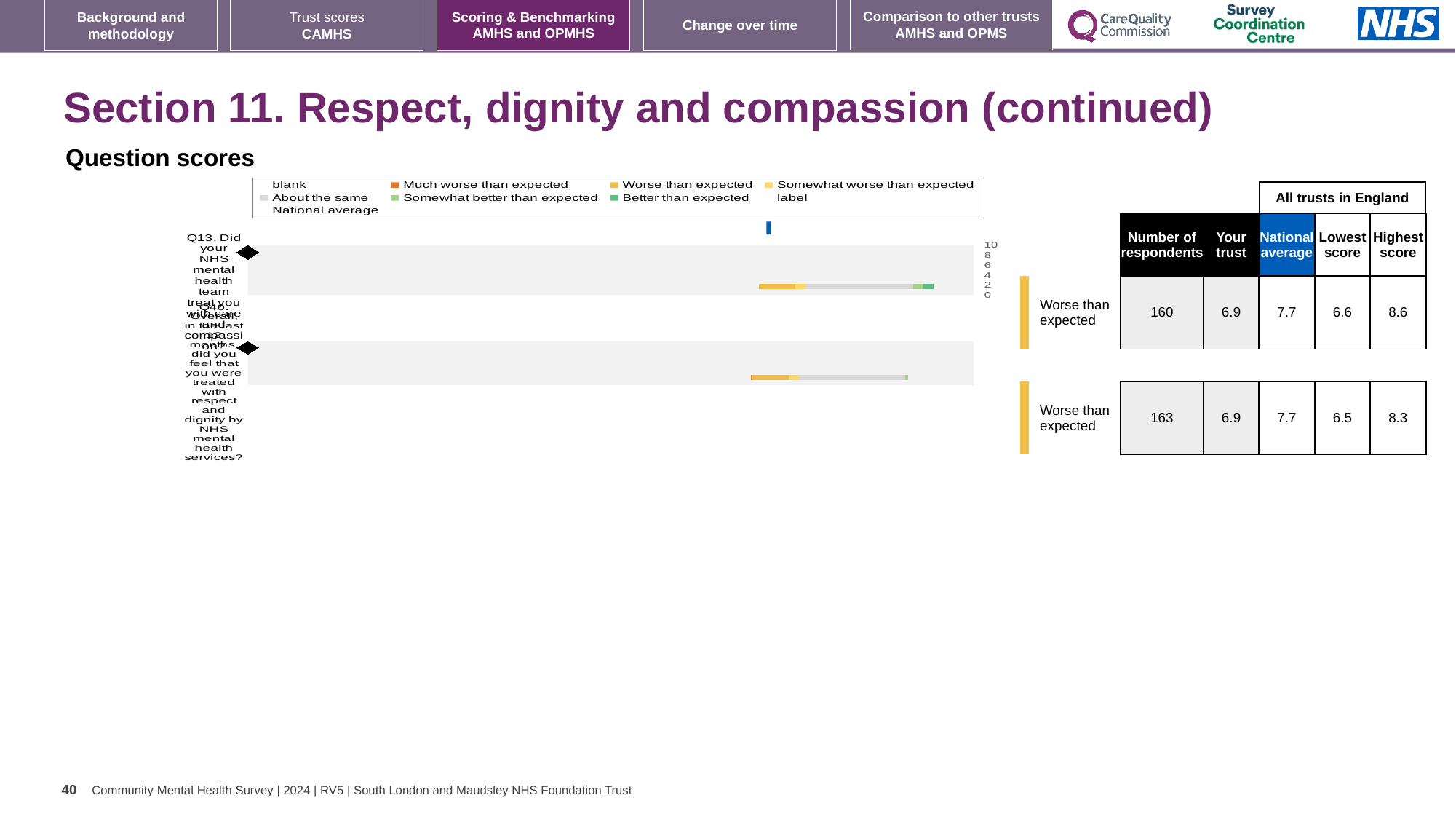
In the table, what is the difference between the Highest score and the Lowest score in the top row (8.6 and 6.6)? 2.0 How many questions (categories) are plotted in the chart? 2 What kind of chart is shown under 'Question scores'? bar chart In the table, what is the Highest score for the top row (160 respondents)? 8.6 In the table, what is the National average for the bottom row (163 respondents)? 7.7 Which row of the table has the higher Number of respondents? the bottom row (163) In the table, what is the 'Your trust' score for the top row (160 respondents)? 6.9 In the table, what is the Lowest score for the bottom row (163 respondents)? 6.5 What label appears beside each bar on the right of the chart? Worse than expected In the table's top row, which is larger: the Your trust score or the National average? National average How many entries does the chart legend list? 9 Which legend entry is shown in grey? About the same